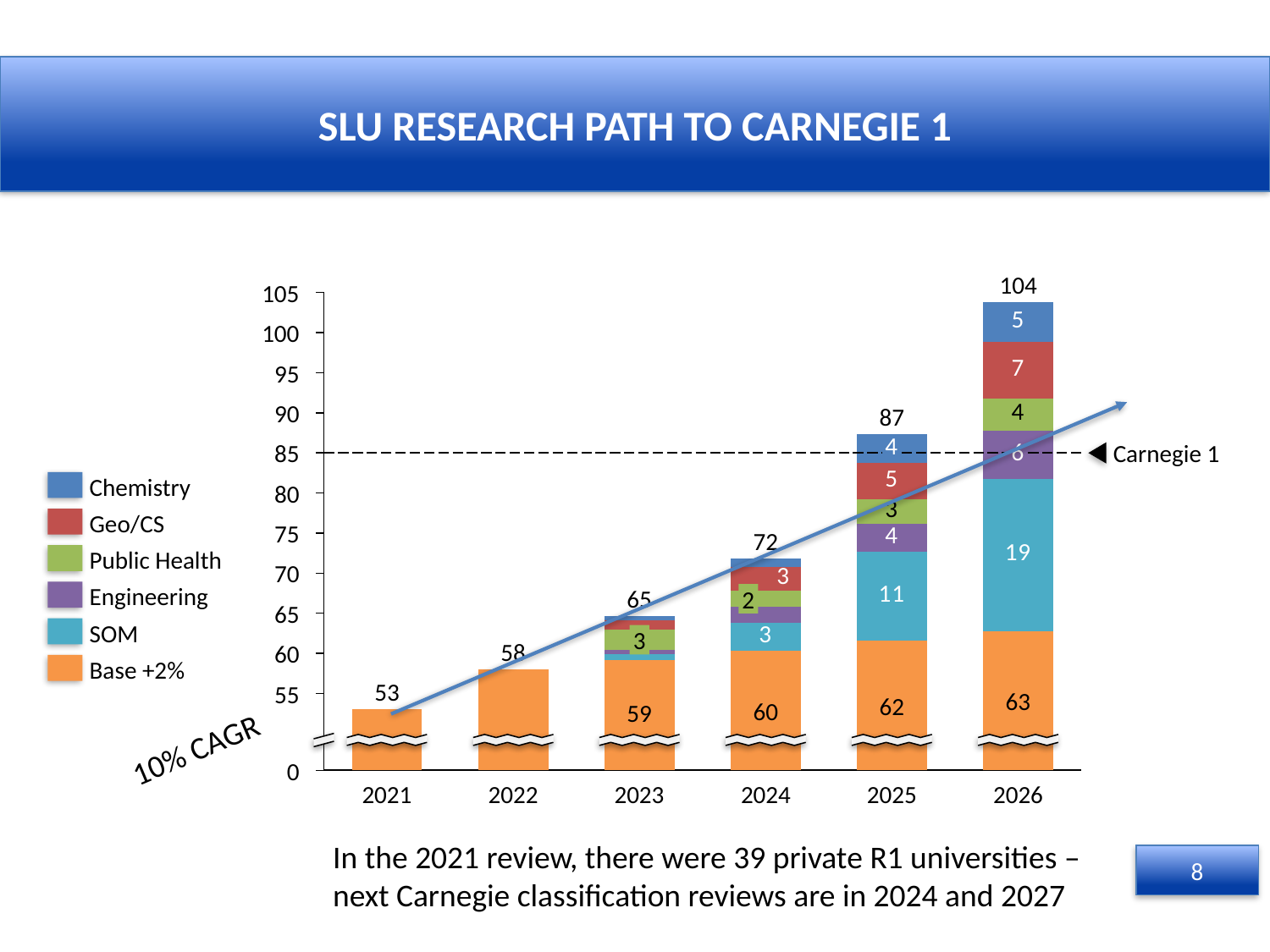
At what value is the dashed Carnegie 1 line drawn? 85 How many years are shown on the x axis? 6 Which year has the highest total? 2026 What is the total value shown for the 2026 bar? 104 Is the SOM value larger in 2025 or in 2026? 2026 What is the Geo/CS value in 2026? 7 What is the SOM value in 2026? 19 What is the Base +2% value in 2025? 62 Which year has the lowest total? 2021 How many series does the legend list? 6 What is the difference between the 2026 total and the 2025 total? 17 What is the total value shown for the 2021 bar? 53